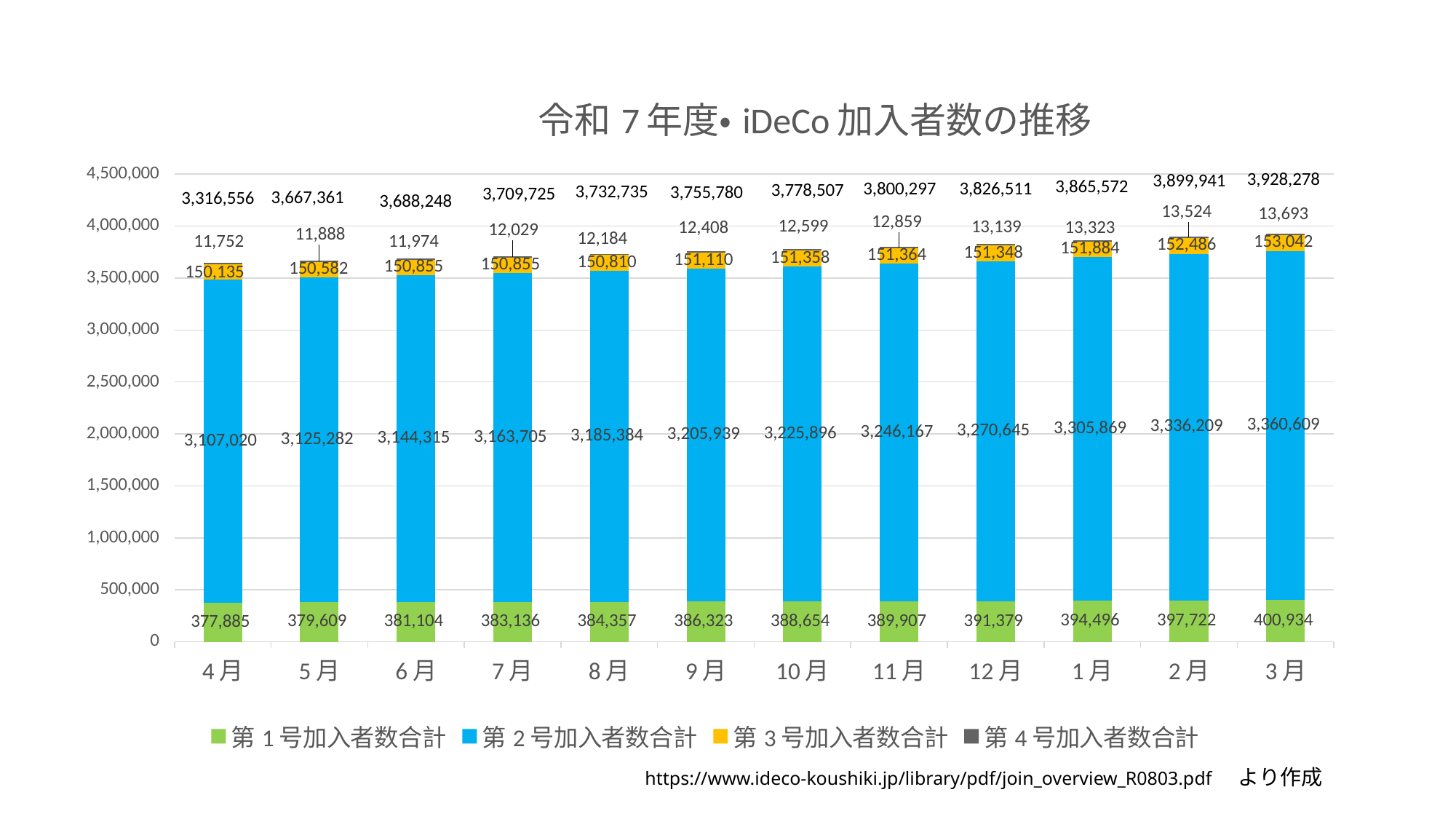
What is the value of 第2号加入者数合計 for 3月? 3,360,609 What is the value of 第3号加入者数合計 for 10月? 151,358 What is the difference between 第1号加入者数合計 in 3月 and in 4月? 23,049 What is the value of 第4号加入者数合計 for 10月? 12,599 In which month is 第1号加入者数合計 lowest? 4月 Which is larger, 第4号加入者数合計 in 9月 or in 11月? 11月 What is the value of 第1号加入者数合計 for 4月? 377,885 In which month is 第2号加入者数合計 highest? 3月 How many series does the legend list? 4 How many months are shown on the x axis? 12 Does 第2号加入者数合計 rise or fall from 4月 to 3月? Rise What kind of chart is shown on the slide? Stacked bar chart